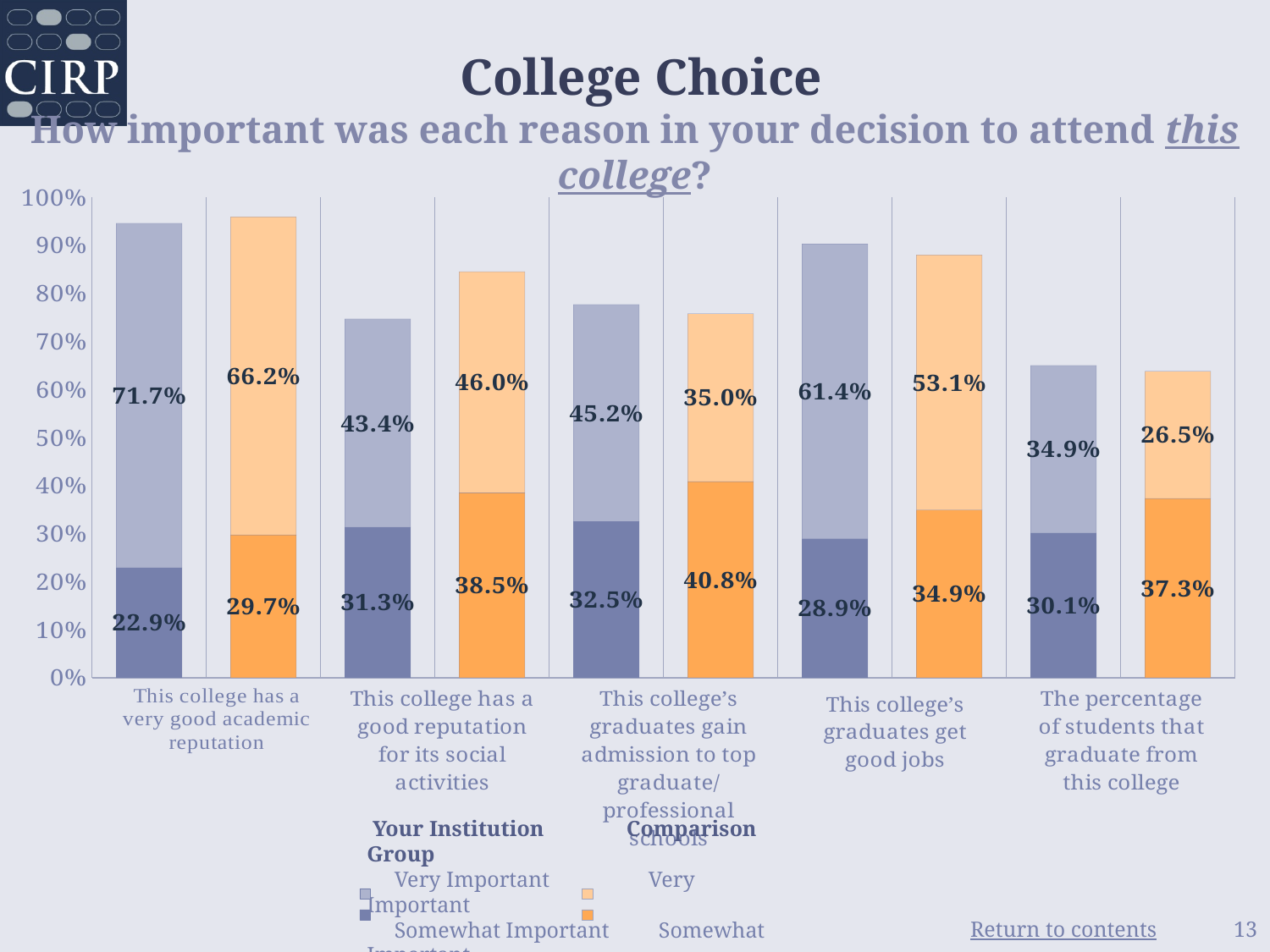
What kind of chart is shown on the slide? Stacked bar chart What is the difference between Your Institution's and the Comparison Group's Very Important percentages for "This college's graduates get good jobs"? 8.3% What is the combined Very Important and Somewhat Important total for Your Institution on "This college has a good reputation for its social activities"? 74.7% What is the combined total of the Comparison Group bar for "This college has a very good academic reputation"? 95.9% For "This college's graduates gain admission to top graduate/professional schools", which group has the larger Somewhat Important percentage? Comparison Group Which reason has the lowest Very Important percentage for the Comparison Group? The percentage of students that graduate from this college What percentage of Your Institution respondents rated "This college has a very good academic reputation" as Very Important? 71.7% What is the Very Important percentage for the Comparison Group on "The percentage of students that graduate from this college"? 26.5% How many reasons (categories) are shown on the x axis? 5 What percentage of the Comparison Group rated "This college's graduates get good jobs" as Somewhat Important? 34.9% How many series does the legend list? 4 Which reason has the highest Very Important percentage for Your Institution? This college has a very good academic reputation